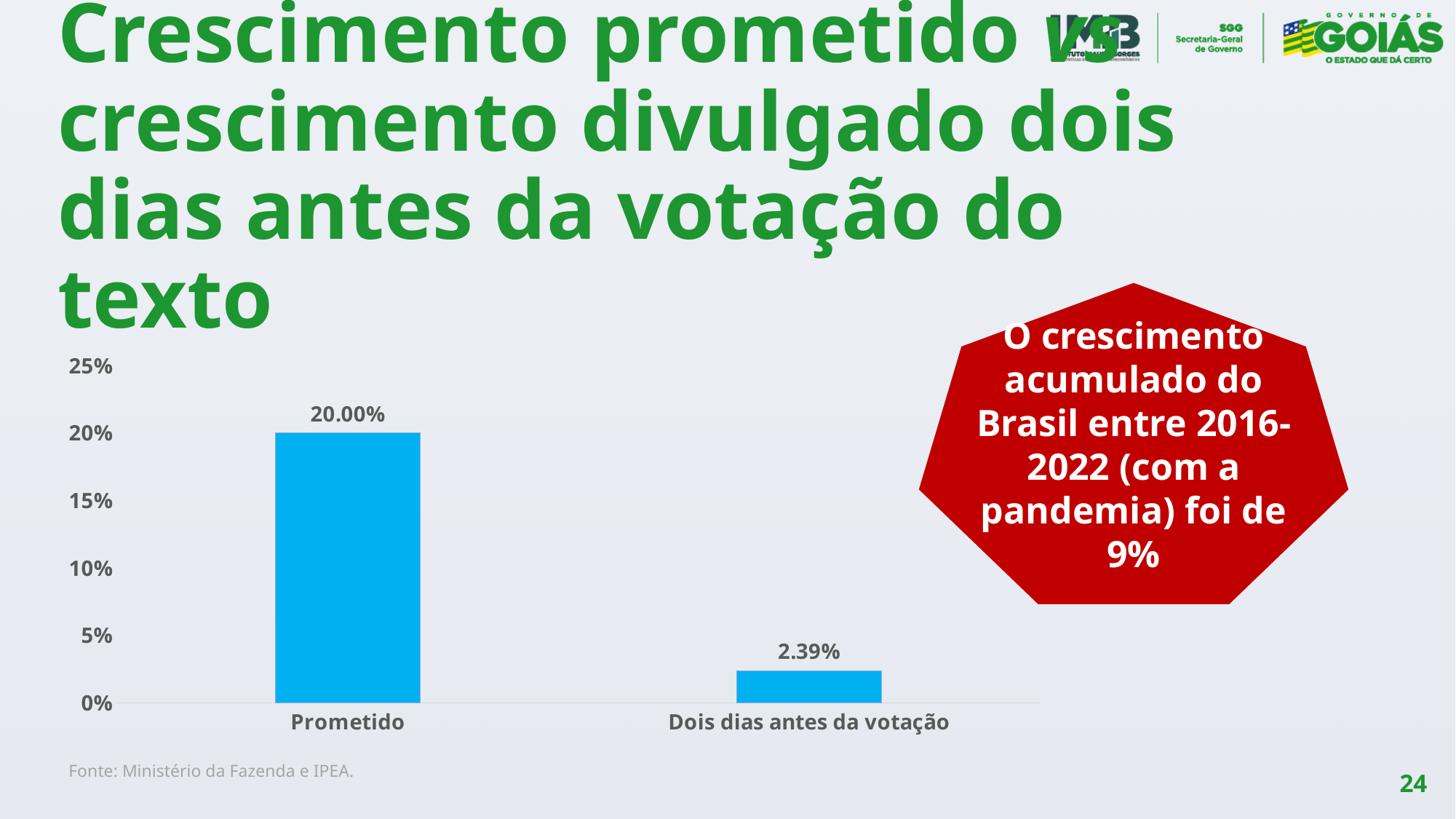
What colour are the bars in the chart? blue Which category has the lowest value? Dois dias antes da votação What is the value for Dois dias antes da votação? 2.39% Which category has the highest value? Prometido What is the difference between the Prometido value and the Dois dias antes da votação value? 17.61% What kind of chart is shown on the slide? bar chart Is the value for Prometido greater or less than 15%? greater What is the maximum value shown on the vertical axis? 25% What is the value for Prometido? 20.00% Is the value for Dois dias antes da votação greater or less than 5%? less Which is larger, the value for Prometido or the value for Dois dias antes da votação? Prometido How many categories are shown in the chart? 2